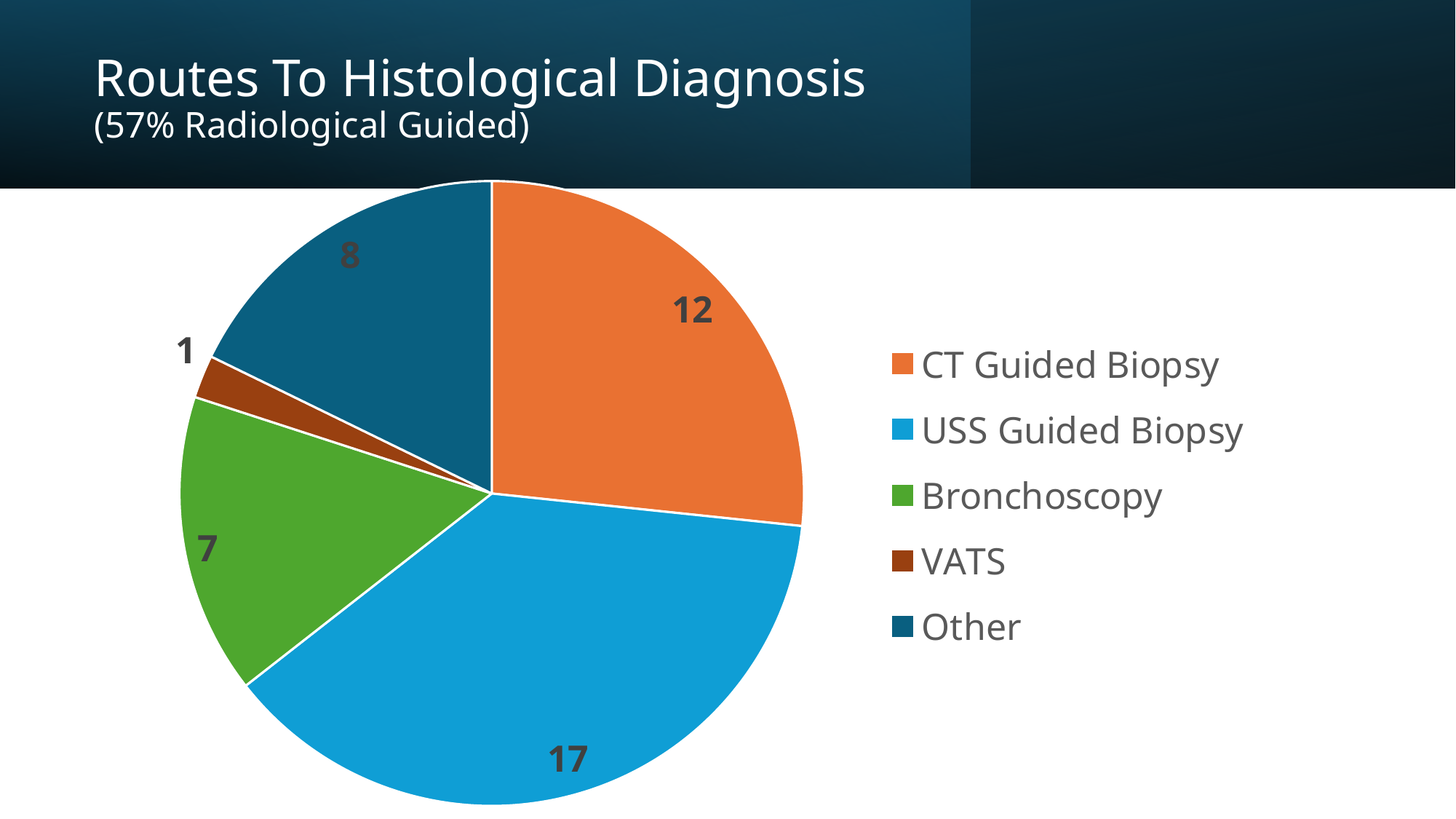
Which route has the largest slice? USS Guided Biopsy What is the value for Other? 8 Which route has the smallest slice? VATS How many categories does the pie chart have? 5 What is the title of the chart on the slide? Routes To Histological Diagnosis What type of chart is shown on the slide? pie chart Which is larger, Other or Bronchoscopy? Other What is the value for CT Guided Biopsy? 12 What is the value for USS Guided Biopsy? 17 What is the value for VATS? 1 What is the value for Bronchoscopy? 7 What is the difference between the values for USS Guided Biopsy and CT Guided Biopsy? 5